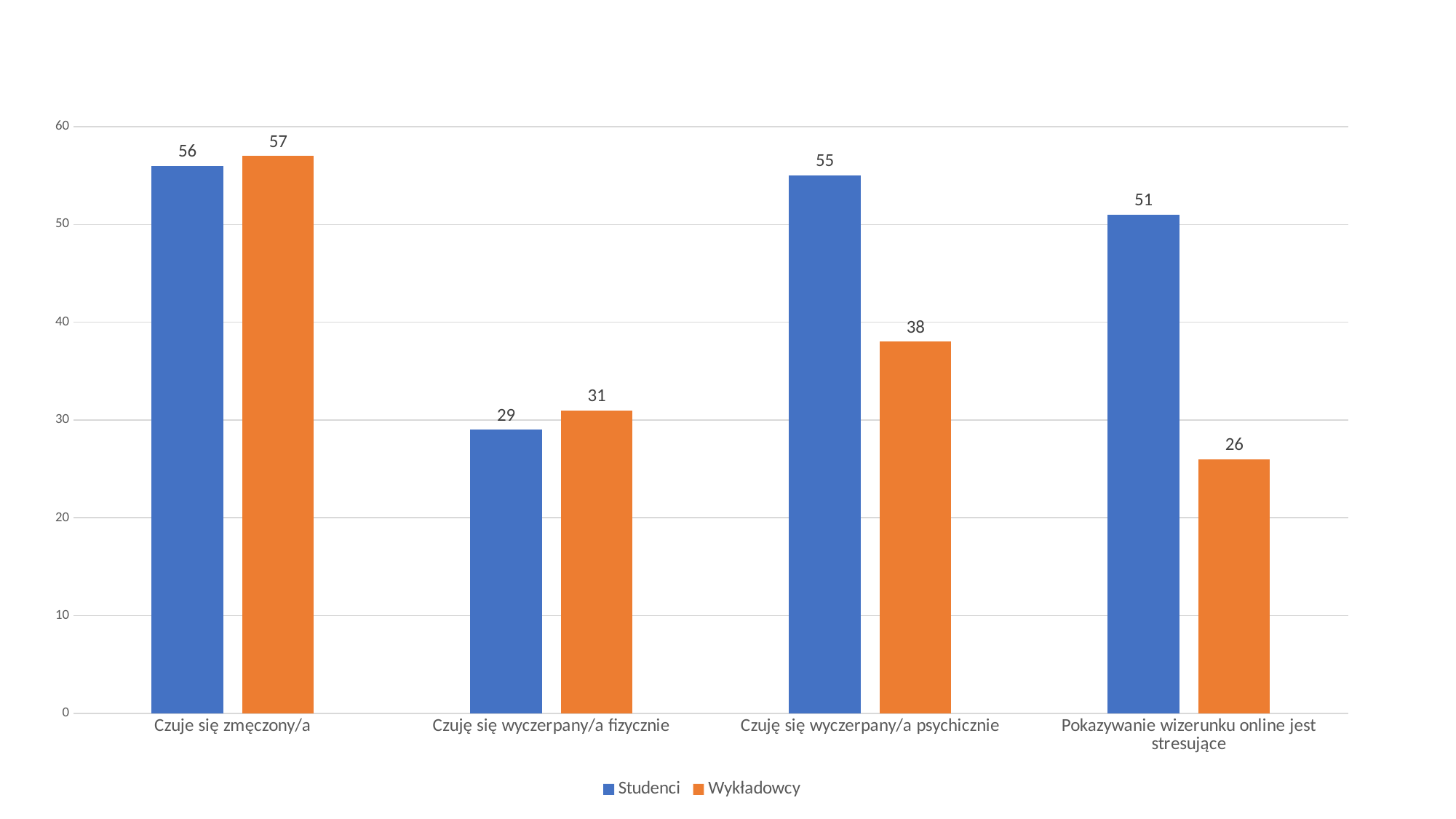
What is the value for Wykładowcy in the category "Pokazywanie wizerunku online jest stresujące"? 26 Is the value for Studenci in "Pokazywanie wizerunku online jest stresujące" greater or less than 40? greater What kind of chart is shown on the slide? bar chart What is the value for Studenci in the category "Czuje się zmęczony/a"? 56 How many series does the legend list? 2 How many categories are shown on the x axis? 4 What is the value for Wykładowcy in the category "Czuję się wyczerpany/a psychicznie"? 38 What is the difference between the Studenci and Wykładowcy values in the category "Czuję się wyczerpany/a psychicznie"? 17 What is the difference between the Studenci and Wykładowcy values in the category "Pokazywanie wizerunku online jest stresujące"? 25 In the category "Czuję się wyczerpany/a fizycznie", which series has the larger value, Studenci or Wykładowcy? Wykładowcy Which category has the highest value for Wykładowcy? Czuje się zmęczony/a Which category has the lowest value for Studenci? Czuję się wyczerpany/a fizycznie